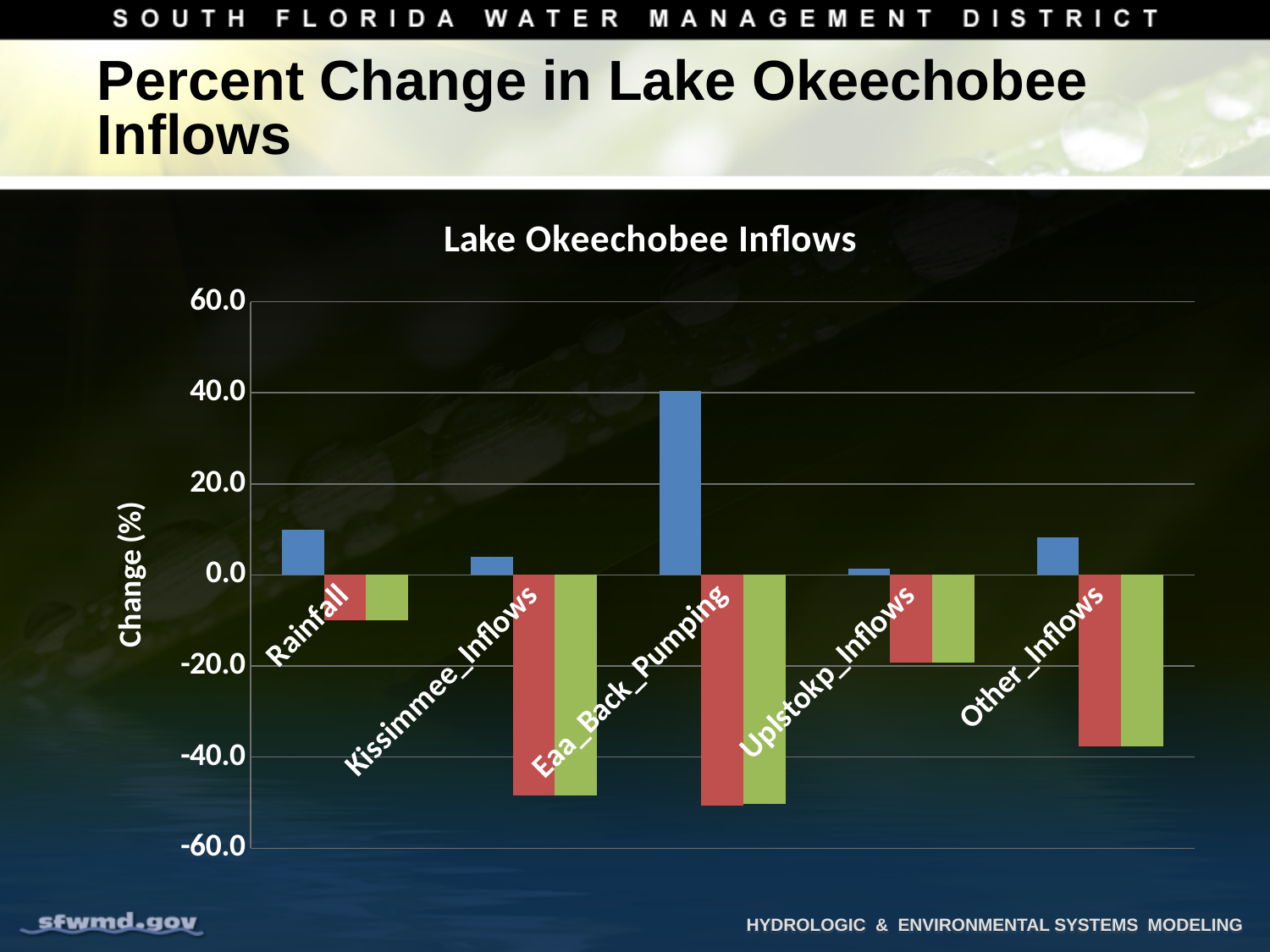
Is the blue bar for Rainfall greater or less than 20.0? less What is the title of the y axis of the chart? Change (%) Is the red bar for Rainfall greater or less than -20.0? greater How many bars are plotted for each category in the chart? 3 Which category has the highest blue bar? Eaa_Back_Pumping Is the red bar for Kissimmee_Inflows greater or less than -40.0? less Which has the larger blue bar, Rainfall or Uplstokp_Inflows? Rainfall Which has the lower red bar, Kissimmee_Inflows or Uplstokp_Inflows? Kissimmee_Inflows How many categories are shown on the x axis of the chart? 5 What kind of chart is shown on the slide? bar chart